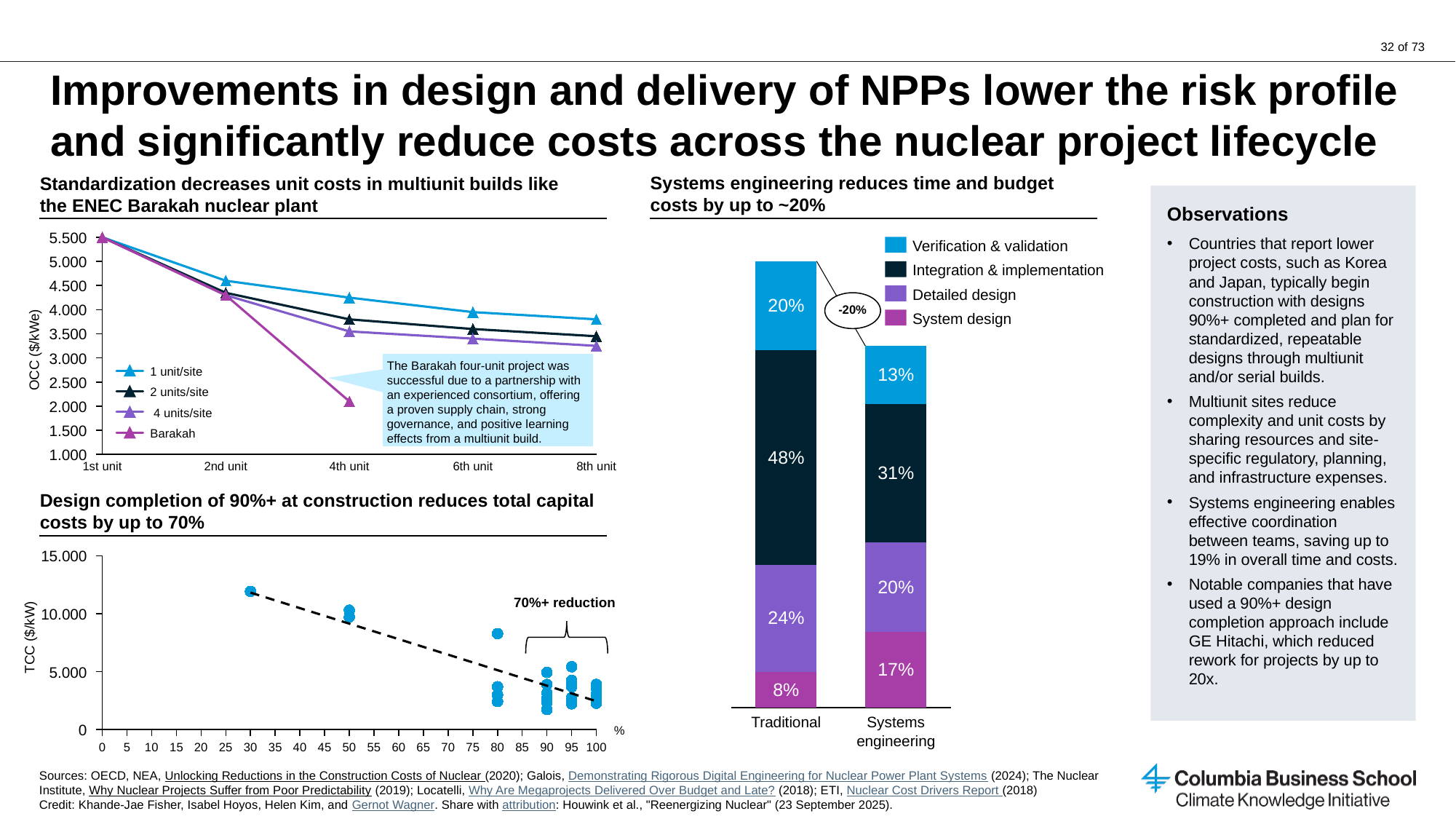
In the 'Systems engineering reduces time and budget costs by up to ~20%' chart, what is the Verification & validation share for the Systems engineering bar? 13% In the 'Design completion of 90%+ at construction reduces total capital costs by up to 70%' chart, do the TCC values rise or fall as design completion increases along the x axis? fall In the 'Systems engineering reduces time and budget costs by up to ~20%' chart, what is the System design share for the Systems engineering bar? 17% In the 'Systems engineering reduces time and budget costs by up to ~20%' chart, how many series does the legend list? 4 In the 'Systems engineering reduces time and budget costs by up to ~20%' chart, which bar has the larger Detailed design share, Traditional or Systems engineering? Traditional In the 'Systems engineering reduces time and budget costs by up to ~20%' chart, which segment is the smallest in the Traditional bar? System design In the 'Systems engineering reduces time and budget costs by up to ~20%' chart, what is the total of the Traditional stacked bar? 100% In the 'Standardization decreases unit costs in multiunit builds like the ENEC Barakah nuclear plant' chart, is the Barakah value at the 4th unit greater or less than 2.500? less In the 'Systems engineering reduces time and budget costs by up to ~20%' chart, what is the Integration & implementation share for the Traditional bar? 48% In the 'Standardization decreases unit costs in multiunit builds like the ENEC Barakah nuclear plant' chart, how many series does the legend list? 4 In the 'Systems engineering reduces time and budget costs by up to ~20%' chart, what is the difference between the Integration & implementation shares of the Traditional and Systems engineering bars? 17% In the 'Standardization decreases unit costs in multiunit builds like the ENEC Barakah nuclear plant' chart, how many unit categories are shown on the x axis? 5